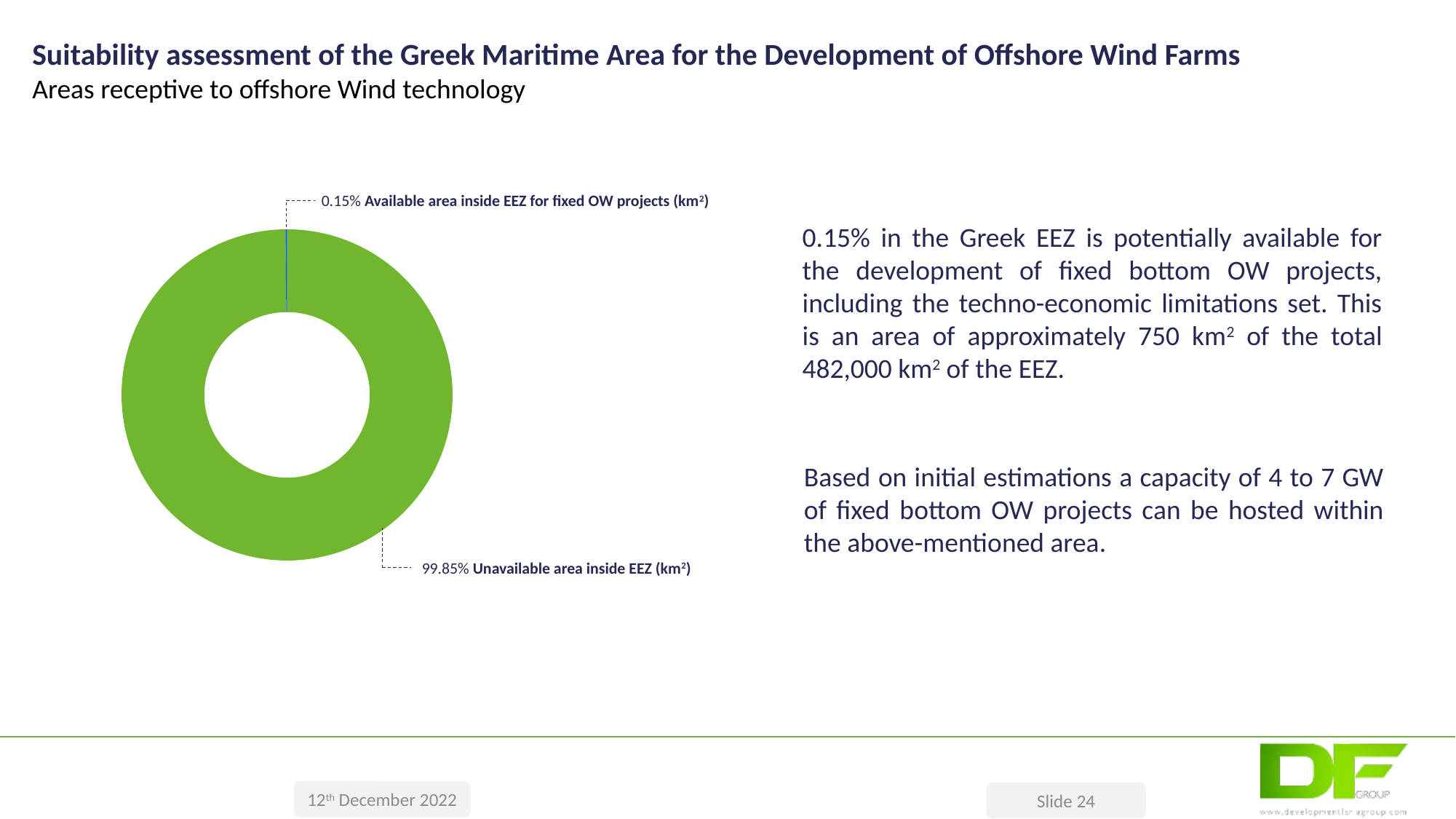
What colour is the 'Available area inside EEZ for fixed OW projects (km²)' slice? Blue Which slice of the chart is the largest? Unavailable area inside EEZ (km²) How many slices does the chart have? 2 Which slice of the chart is the smallest? Available area inside EEZ for fixed OW projects (km²) Which is larger: the available area slice or the unavailable area slice? Unavailable area inside EEZ (km²) What kind of chart is shown on the slide? Doughnut (pie) chart Is the share for 'Unavailable area inside EEZ (km²)' greater or less than 50%? greater What is the difference in percentage points between the unavailable and available area slices? 99.7 What share of the chart is labelled 'Unavailable area inside EEZ (km²)'? 99.85% What share of the chart is labelled 'Available area inside EEZ for fixed OW projects (km²)'? 0.15% What colour is the 'Unavailable area inside EEZ (km²)' slice? Green